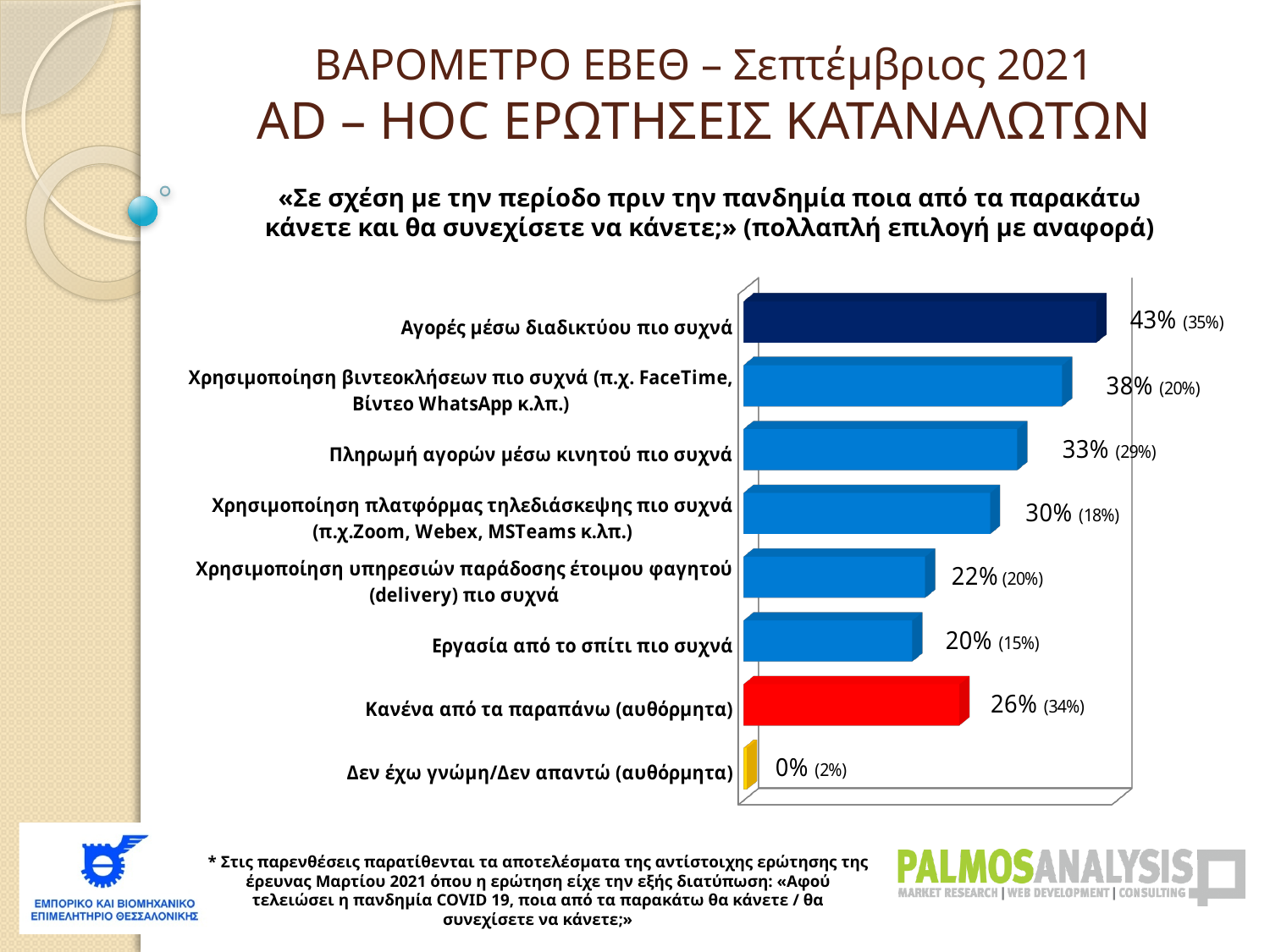
What is the difference between the values for "Αγορές μέσω διαδικτύου πιο συχνά" and "Χρησιμοποίηση βιντεοκλήσεων πιο συχνά"? 5% How many categories does the bar chart show? 8 Which category has the lowest value? Δεν έχω γνώμη/Δεν απαντώ (αυθόρμητα) Which is larger: the value for "Χρησιμοποίηση υπηρεσιών παράδοσης έτοιμου φαγητού (delivery) πιο συχνά" or for "Κανένα από τα παραπάνω (αυθόρμητα)"? Κανένα από τα παραπάνω (αυθόρμητα) What is the value for "Αγορές μέσω διαδικτύου πιο συχνά"? 43% What is the difference between the current value and the March 2021 value in parentheses for "Χρησιμοποίηση βιντεοκλήσεων πιο συχνά"? 18% What colour is the bar for "Κανένα από τα παραπάνω (αυθόρμητα)"? red What is the value for "Εργασία από το σπίτι πιο συχνά"? 20% Which category has the highest value? Αγορές μέσω διαδικτύου πιο συχνά What is the March 2021 value shown in parentheses for "Πληρωμή αγορών μέσω κινητού πιο συχνά"? 29% What is the value for "Κανένα από τα παραπάνω (αυθόρμητα)"? 26% What kind of chart is shown on the slide? bar chart